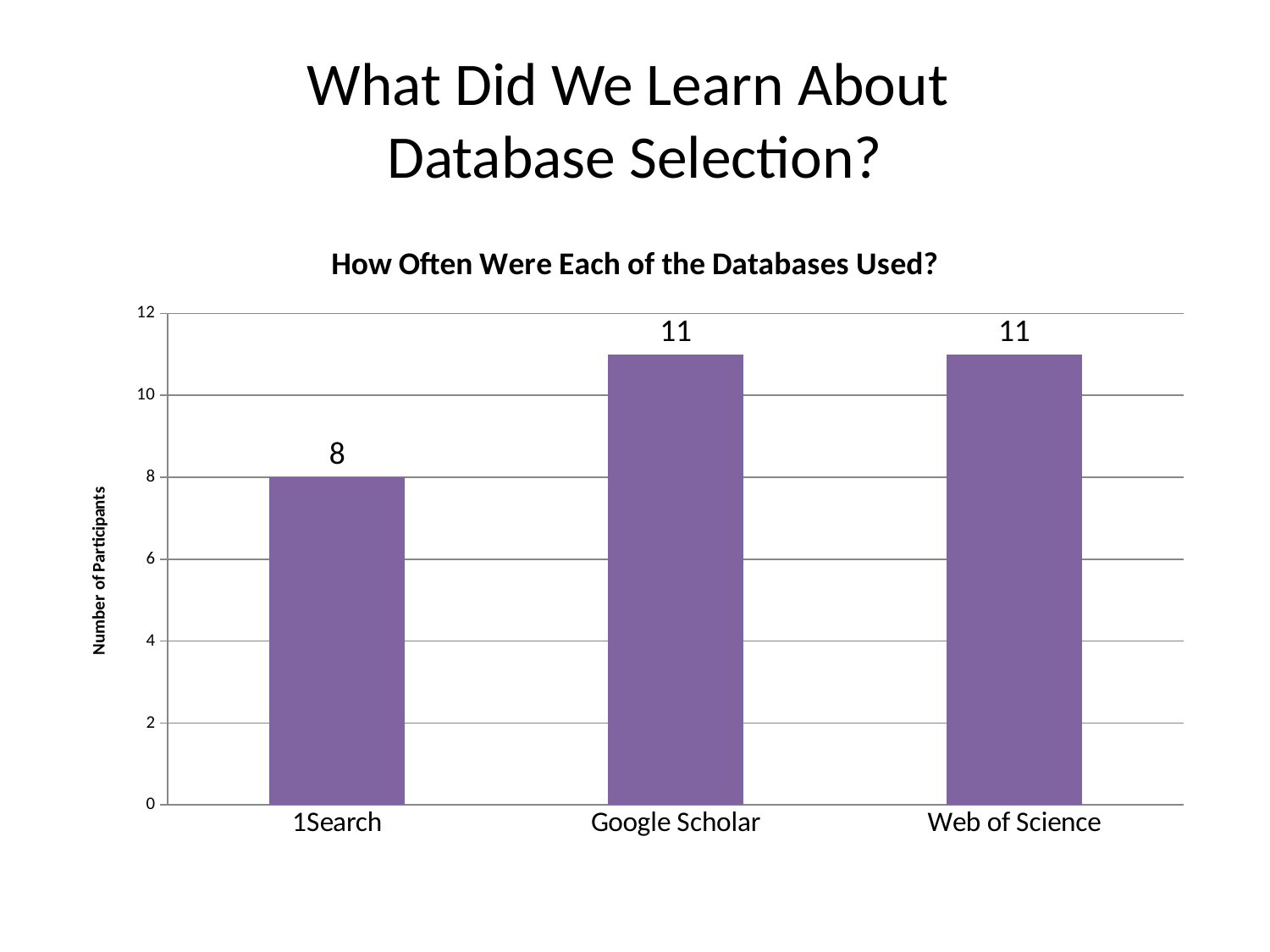
What is the title of the chart? How Often Were Each of the Databases Used? How many databases are shown on the x axis? 3 What is the value for Web of Science? 11 What is the label of the vertical axis? Number of Participants Which is larger, the value for 1Search or the value for Web of Science? Web of Science What is the value for 1Search? 8 Is the value for 1Search greater or less than 10? less What is the total of the values for all three databases? 30 Which database has the lowest number of participants? 1Search What is the value for Google Scholar? 11 What is the difference between the values for Google Scholar and 1Search? 3 What kind of chart is shown on the slide? bar chart